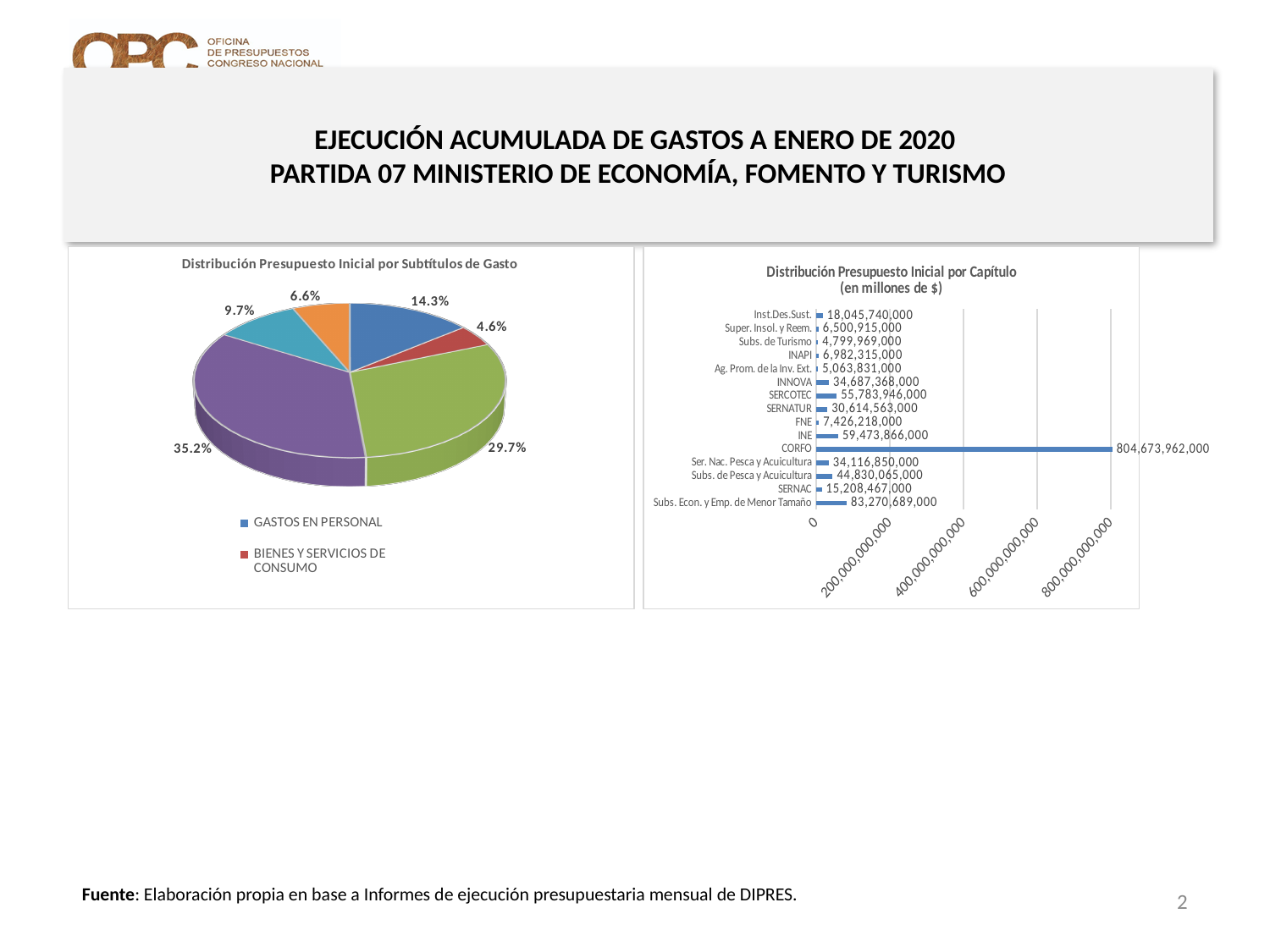
In the pie chart 'Distribución Presupuesto Inicial por Subtítulos de Gasto', what share does GASTOS EN PERSONAL have? 14.3% In the chart 'Distribución Presupuesto Inicial por Capítulo', what is the value for CORFO? 804,673,962,000 In the chart 'Distribución Presupuesto Inicial por Capítulo', what is the value for SERCOTEC? 55,783,946,000 What kind of chart is 'Distribución Presupuesto Inicial por Capítulo'? Bar chart What kind of chart is 'Distribución Presupuesto Inicial por Subtítulos de Gasto'? Pie chart In the chart 'Distribución Presupuesto Inicial por Capítulo', what is the value for Subs. de Turismo? 4,799,969,000 In the chart 'Distribución Presupuesto Inicial por Capítulo', how many capítulos are shown? 15 In the chart 'Distribución Presupuesto Inicial por Capítulo', which capítulo has the highest value? CORFO In the chart 'Distribución Presupuesto Inicial por Capítulo', what is the difference between the values for INE and INNOVA? 24,786,498,000 In the chart 'Distribución Presupuesto Inicial por Capítulo', which is larger: SERNATUR or Ser. Nac. Pesca y Acuicultura? Ser. Nac. Pesca y Acuicultura In the chart 'Distribución Presupuesto Inicial por Capítulo', which capítulo has the lowest value? Subs. de Turismo In the pie chart 'Distribución Presupuesto Inicial por Subtítulos de Gasto', what share does BIENES Y SERVICIOS DE CONSUMO have? 4.6%